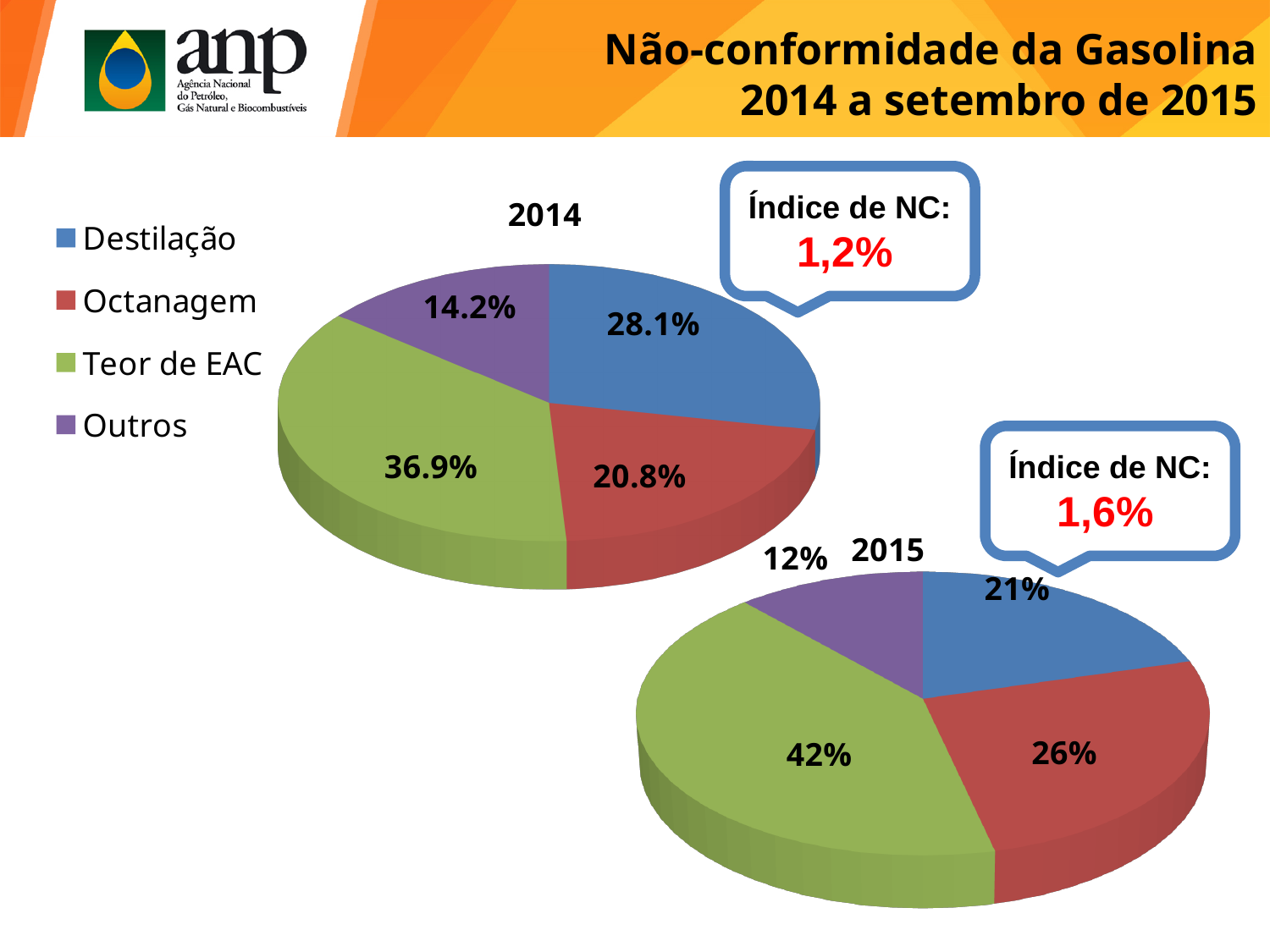
In the 2015 pie chart, which is larger, Destilação or Octanagem? Octanagem In the 2014 pie chart, what share does Teor de EAC have? 36.9% What type of chart is used to show the 2014 data? Pie chart In the 2015 pie chart, what share does Octanagem have? 26% In the 2014 pie chart, what is the difference between the Destilação and Octanagem shares? 7.3% In the 2014 pie chart, what share does Destilação have? 28.1% Which colour represents Teor de EAC in the legend? Green In the 2014 pie chart, which category has the largest slice? Teor de EAC In the 2015 pie chart, what share does Outros have? 12% How many slices does the 2015 pie chart have? 4 In the 2015 pie chart, which category has the smallest slice? Outros How many entries does the legend list? 4